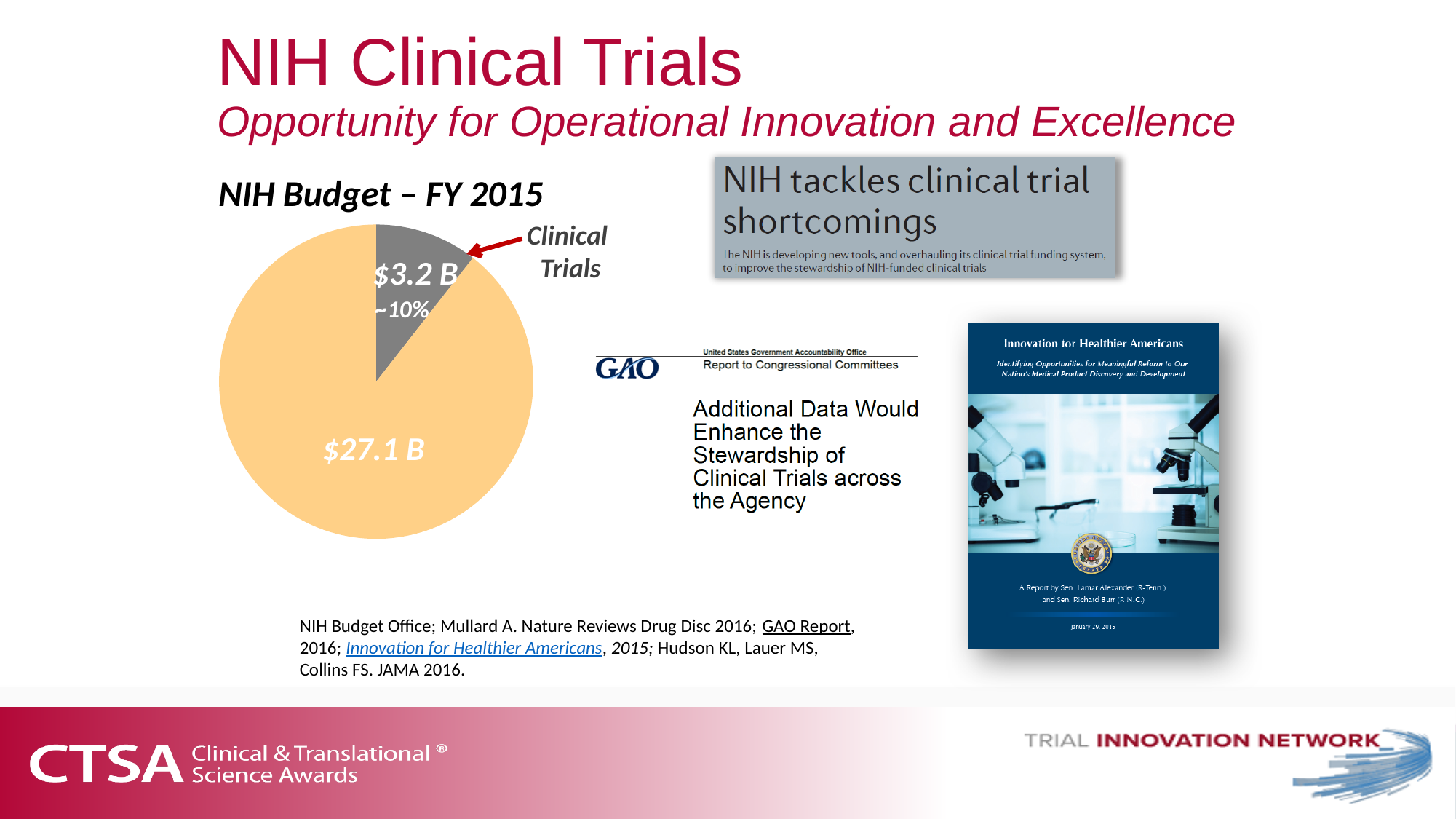
In the NIH Budget – FY 2015 pie chart, what is the smallest slice? Clinical Trials ($3.2 B) What is the title of the pie chart on the slide? NIH Budget – FY 2015 What kind of chart is shown under the heading "NIH Budget – FY 2015"? pie chart How many slices does the NIH Budget – FY 2015 pie chart have? 2 What colour is the Clinical Trials slice in the NIH Budget – FY 2015 pie chart? gray In the NIH Budget – FY 2015 pie chart, what percentage label is printed on the Clinical Trials slice? ~10% In the NIH Budget – FY 2015 pie chart, what value is shown on the large orange slice? $27.1 B In the NIH Budget – FY 2015 pie chart, which slice is larger: the Clinical Trials slice or the orange slice? the orange slice ($27.1 B) In the NIH Budget – FY 2015 pie chart, what is the total of the two slice values shown? $30.3 B In the NIH Budget – FY 2015 pie chart, what is the difference between the $27.1 B slice and the Clinical Trials slice? $23.9 B In the NIH Budget – FY 2015 pie chart, what value is shown for Clinical Trials? $3.2 B